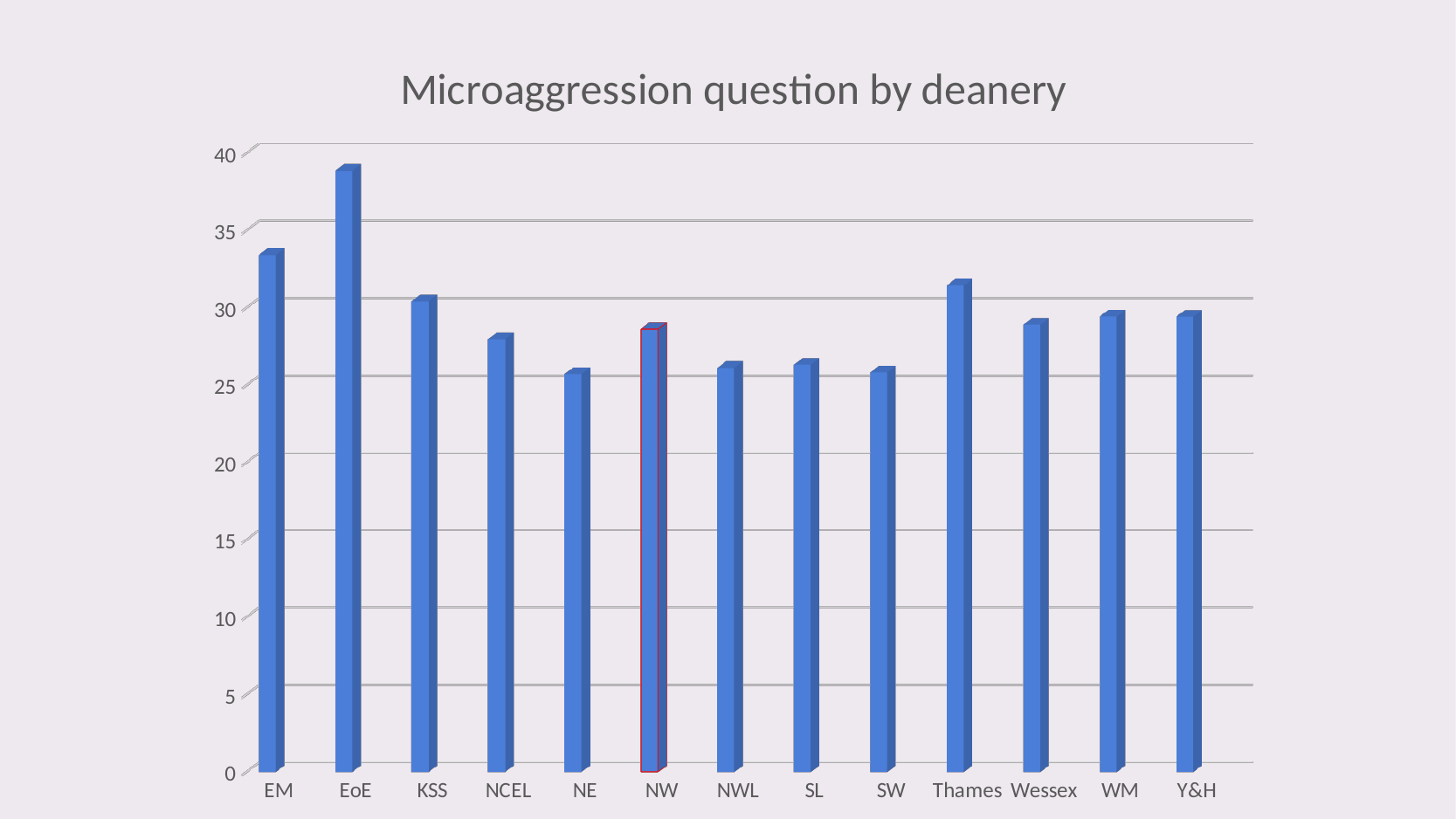
What kind of chart is shown on the slide? bar chart Which bar is outlined in red? NW Is the value for Thames greater or less than 30? greater What is the title of the chart? Microaggression question by deanery Is the value for NCEL greater or less than 30? less Is the value for Wessex greater or less than 30? less Which is larger, the value for EM or the value for KSS? EM Which is larger, the value for Thames or the value for NCEL? Thames Which deanery has the highest value? EoE How many deaneries are shown on the x axis? 13